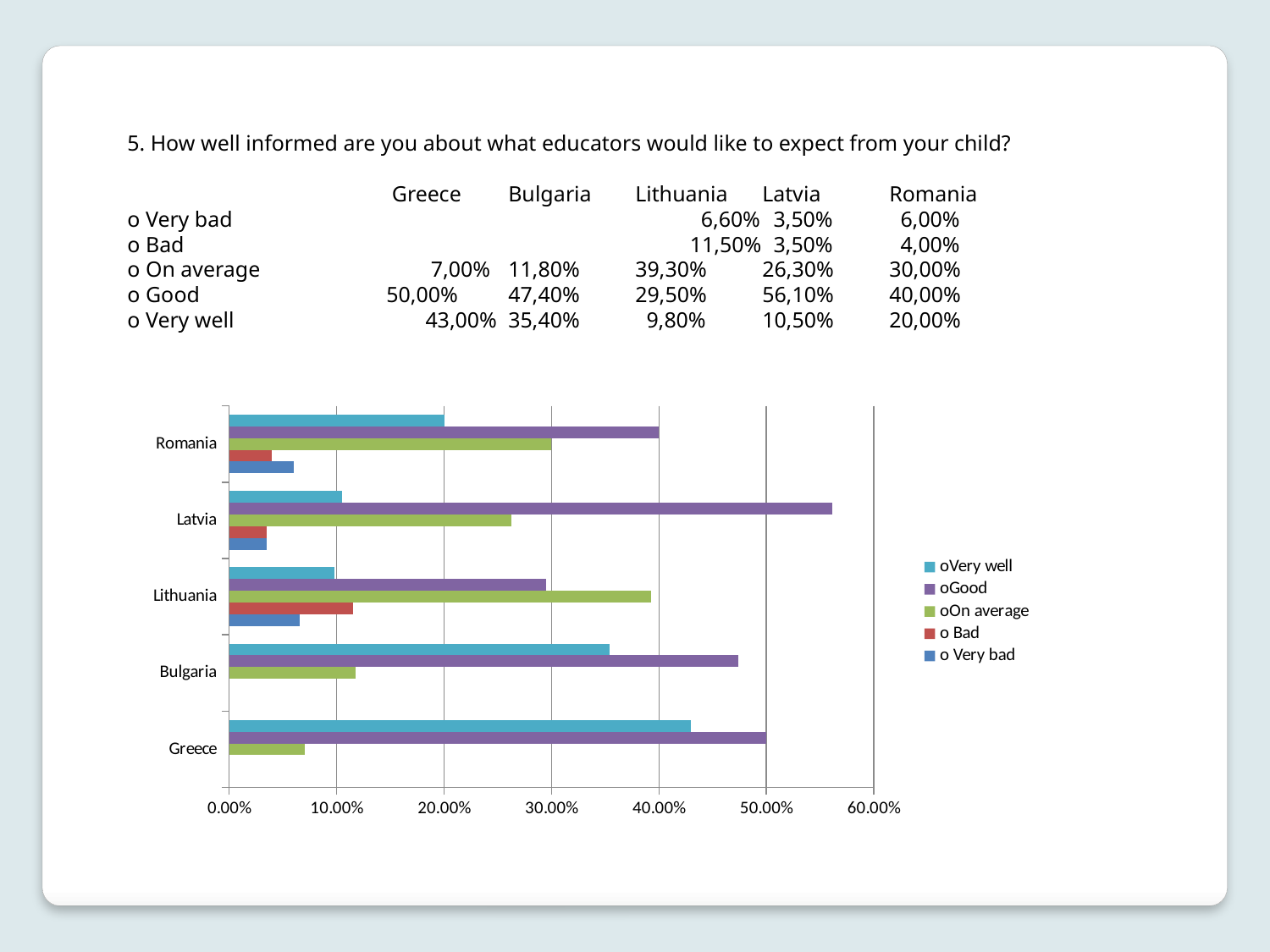
Which country has the highest 'Good' value? Latvia How many countries are shown on the chart's vertical axis? 5 What is the 'Good' value for Latvia? 56,10% Which country has the lowest 'Very well' value? Lithuania What kind of chart is shown on the slide? bar chart Which colour represents the 'Good' series in the chart? purple What is the 'On average' value for Lithuania? 39,30% What is the 'Very well' value for Greece? 43,00% Is the 'Good' value for Latvia greater or less than 50.00%? greater What is the difference between the 'Good' values for Greece and Romania? 10,00% Which is larger for Bulgaria: the 'Good' value or the 'Very well' value? Good How many series does the chart legend list? 5